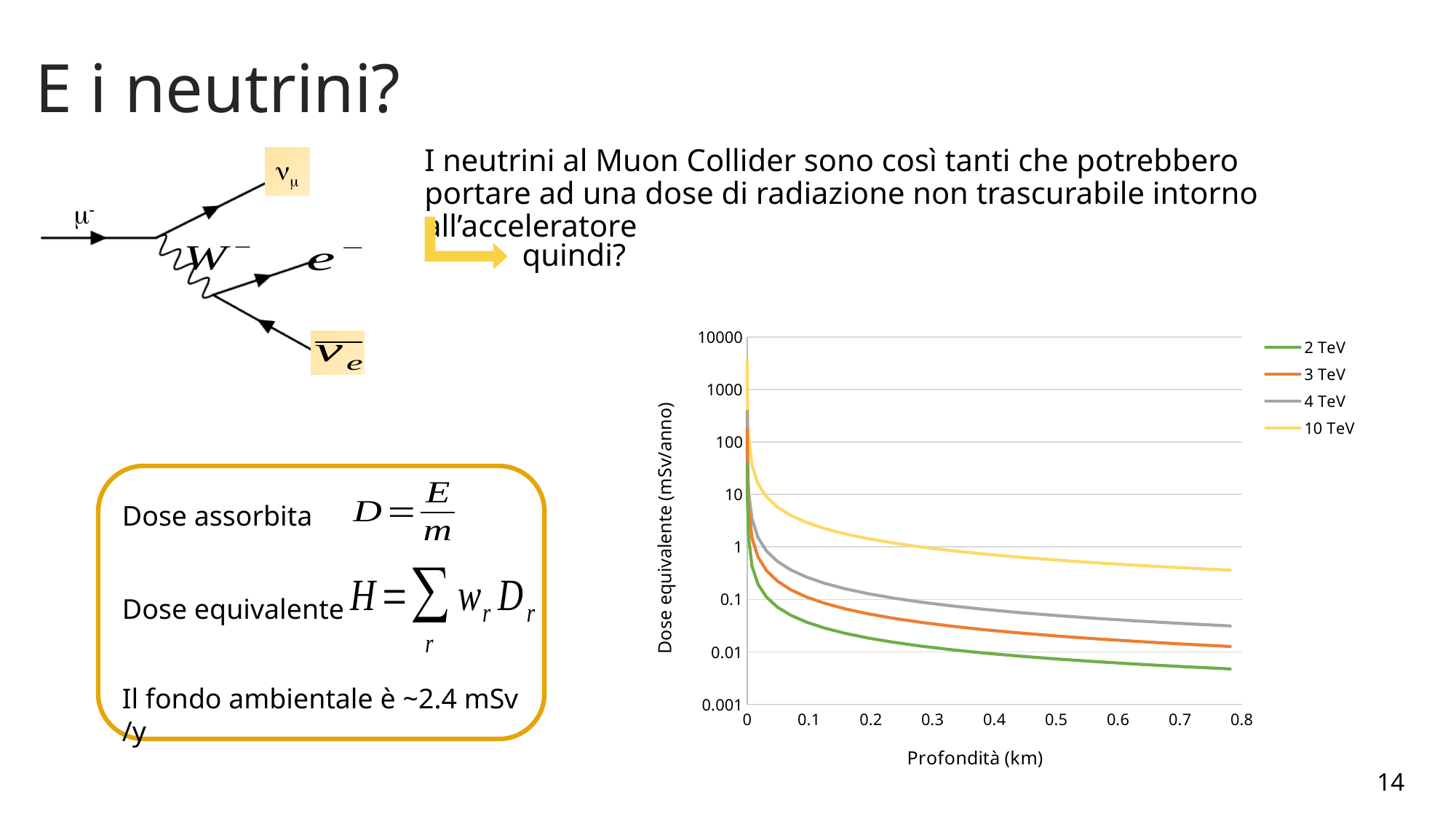
Is the dose equivalent for the 2 TeV series at a depth of 0.8 km greater or less than 0.01 mSv/anno? less What is the label of the chart's x axis? Profondità (km) Which series has the highest dose equivalent at a depth of 0.4 km? 10 TeV At a depth of 0.6 km, which series has the larger dose equivalent, 3 TeV or 4 TeV? 4 TeV How many series does the chart legend list? 4 Is the dose equivalent for the 10 TeV series at a depth of 0.8 km greater or less than 1 mSv/anno? less Which series has the lowest dose equivalent at a depth of 0.4 km? 2 TeV Which series are listed in the chart legend? 2 TeV, 3 TeV, 4 TeV, 10 TeV Do the values of the 10 TeV series rise or fall as depth increases along the x axis? fall Is the dose equivalent for the 4 TeV series at a depth of 0.8 km greater or less than 0.01 mSv/anno? greater What kind of chart is shown on the slide? line chart